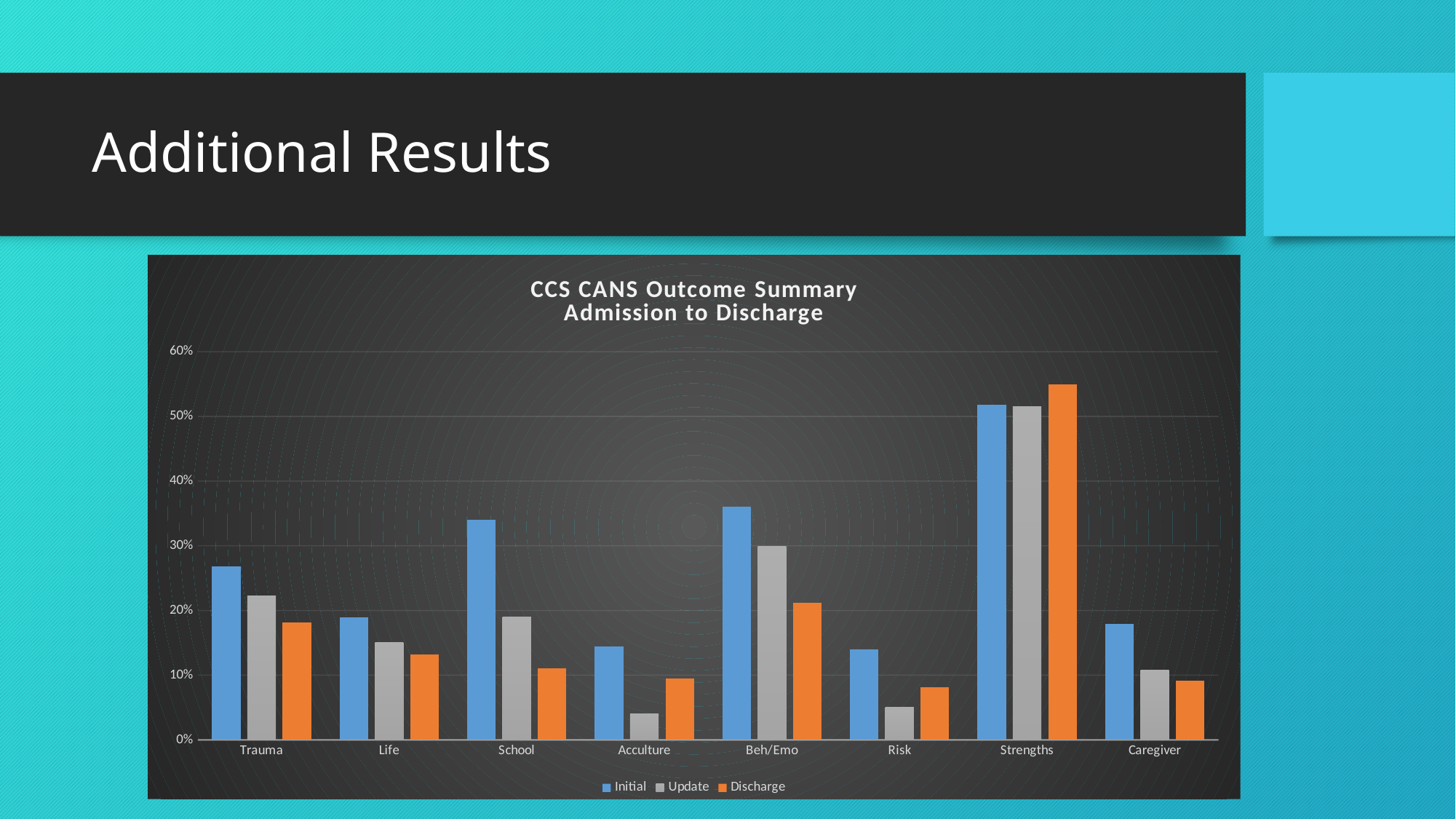
Is the Discharge value for Strengths greater or less than 50%? greater What kind of chart is shown on the slide? bar chart Which category has the highest Initial value? Strengths Is the Initial value for School greater or less than 30%? greater Is the Update value for Acculture greater or less than 10%? less For Strengths, which is larger: the Initial value or the Discharge value? Discharge How many series does the legend list? 3 What is the title of the chart? CCS CANS Outcome Summary Admission to Discharge Which category has the highest Discharge value? Strengths For Trauma, which is larger: the Initial value or the Discharge value? Initial How many categories are shown on the x axis? 8